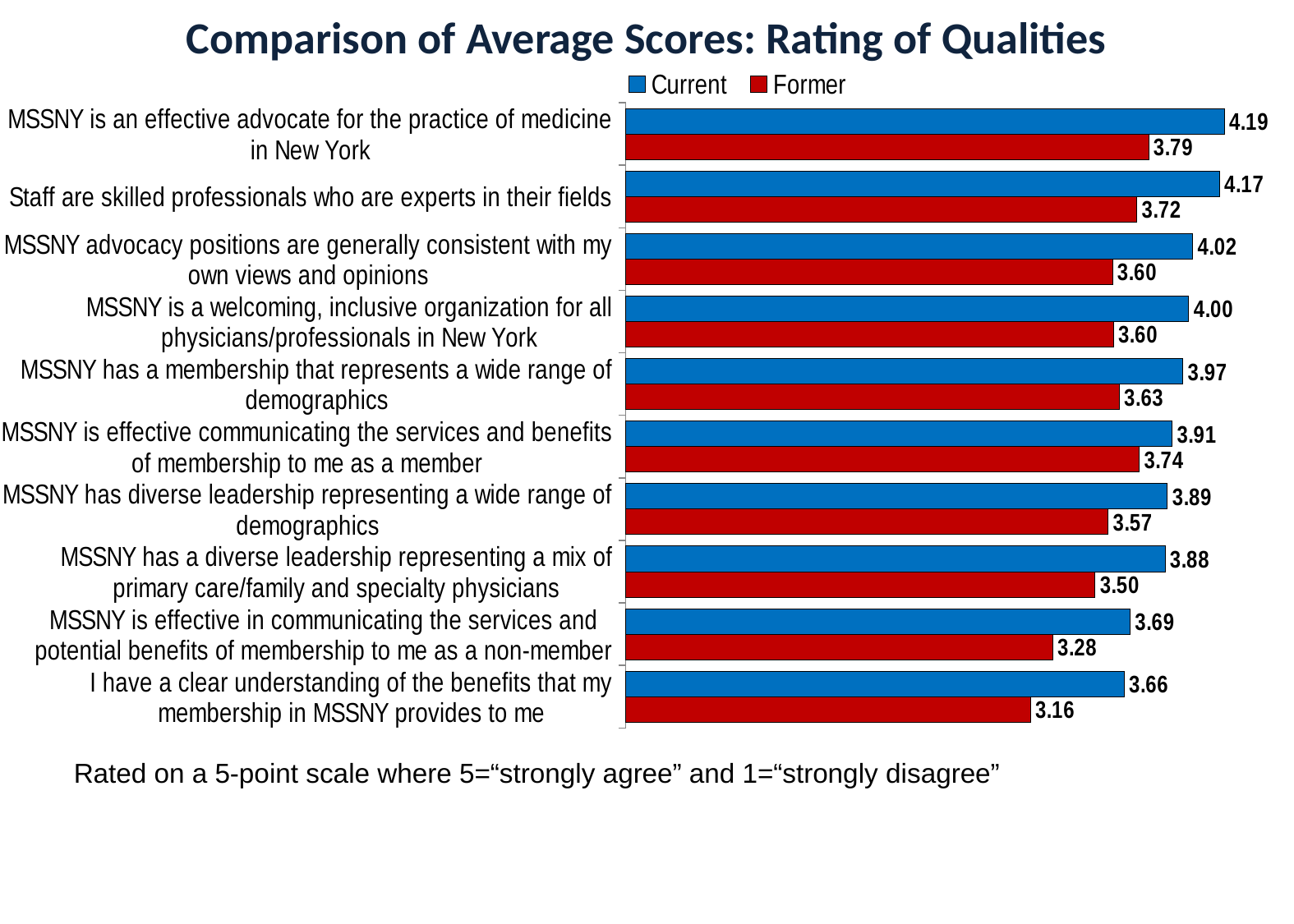
What is the title of the chart? Comparison of Average Scores: Rating of Qualities Which is larger for "MSSNY is effective communicating the services and benefits of membership to me as a member": the Current score or the Former score? Current How many series does the legend list? 2 How many qualities are listed on the chart? 10 What is the Current score for "MSSNY is an effective advocate for the practice of medicine in New York"? 4.19 Which quality has the lowest Former score? I have a clear understanding of the benefits that my membership in MSSNY provides to me Which quality has the highest Current score? MSSNY is an effective advocate for the practice of medicine in New York What is the Former score for "I have a clear understanding of the benefits that my membership in MSSNY provides to me"? 3.16 What is the difference between the Current and Former scores for "MSSNY has a diverse leadership representing a mix of primary care/family and specialty physicians"? 0.38 Which colour represents the Former series? Red What is the Former score for "Staff are skilled professionals who are experts in their fields"? 3.72 What kind of chart is shown on the slide? Bar chart